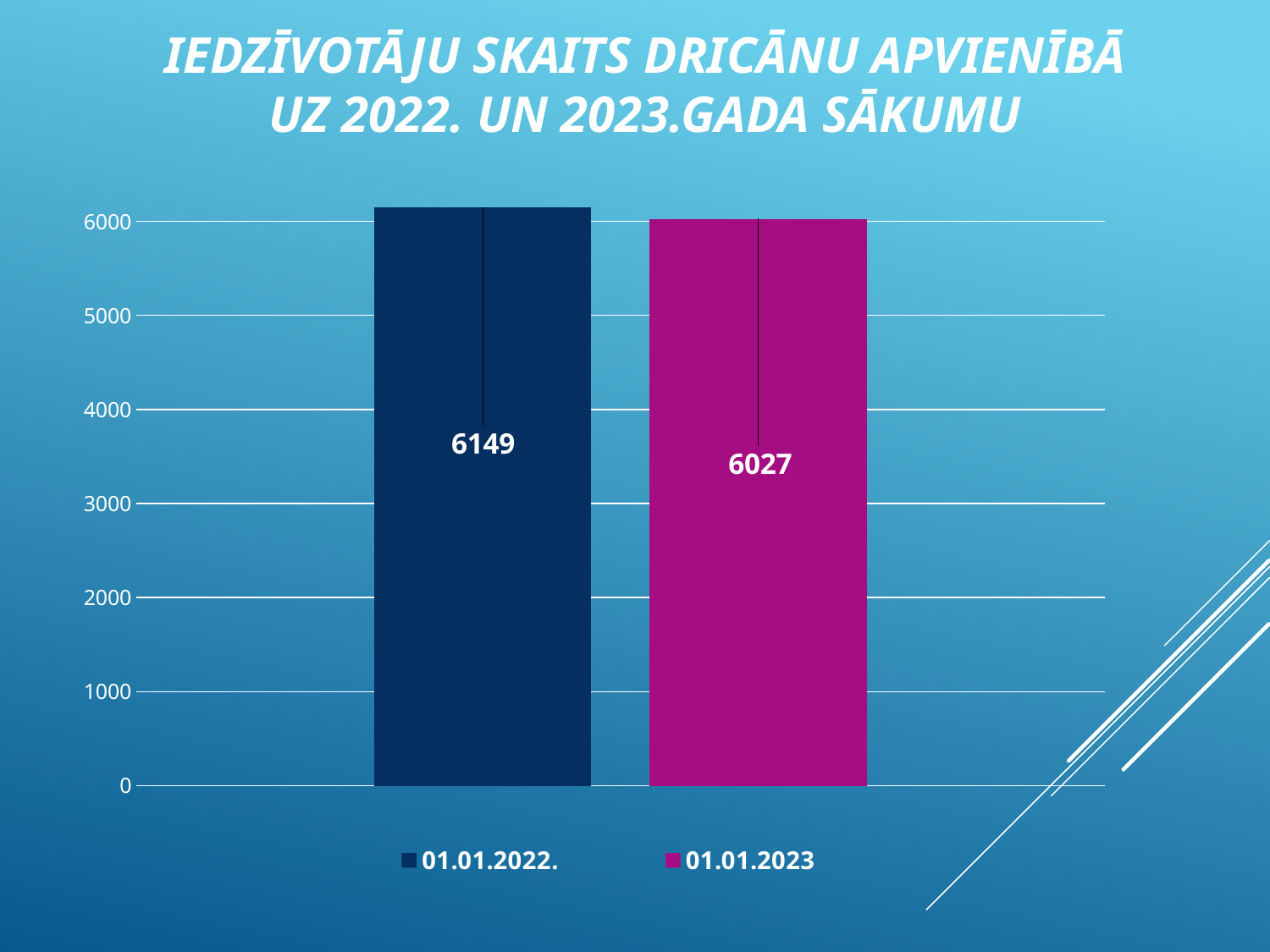
Did the population fall or rise from 01.01.2022. to 01.01.2023? fall What is the value for 01.01.2022.? 6149 How many bars are plotted on the chart? 2 What colour is the bar for 01.01.2023? magenta What is the difference between the values for 01.01.2022. and 01.01.2023? 122 Is the value for 01.01.2023 greater or less than 6000? greater Which series has the lower value? 01.01.2023 How many series does the legend list? 2 What is the value for 01.01.2023? 6027 Which series has the higher value, 01.01.2022. or 01.01.2023? 01.01.2022. What kind of chart is shown on the slide? bar chart Is the value for 01.01.2022. greater or less than 5000? greater